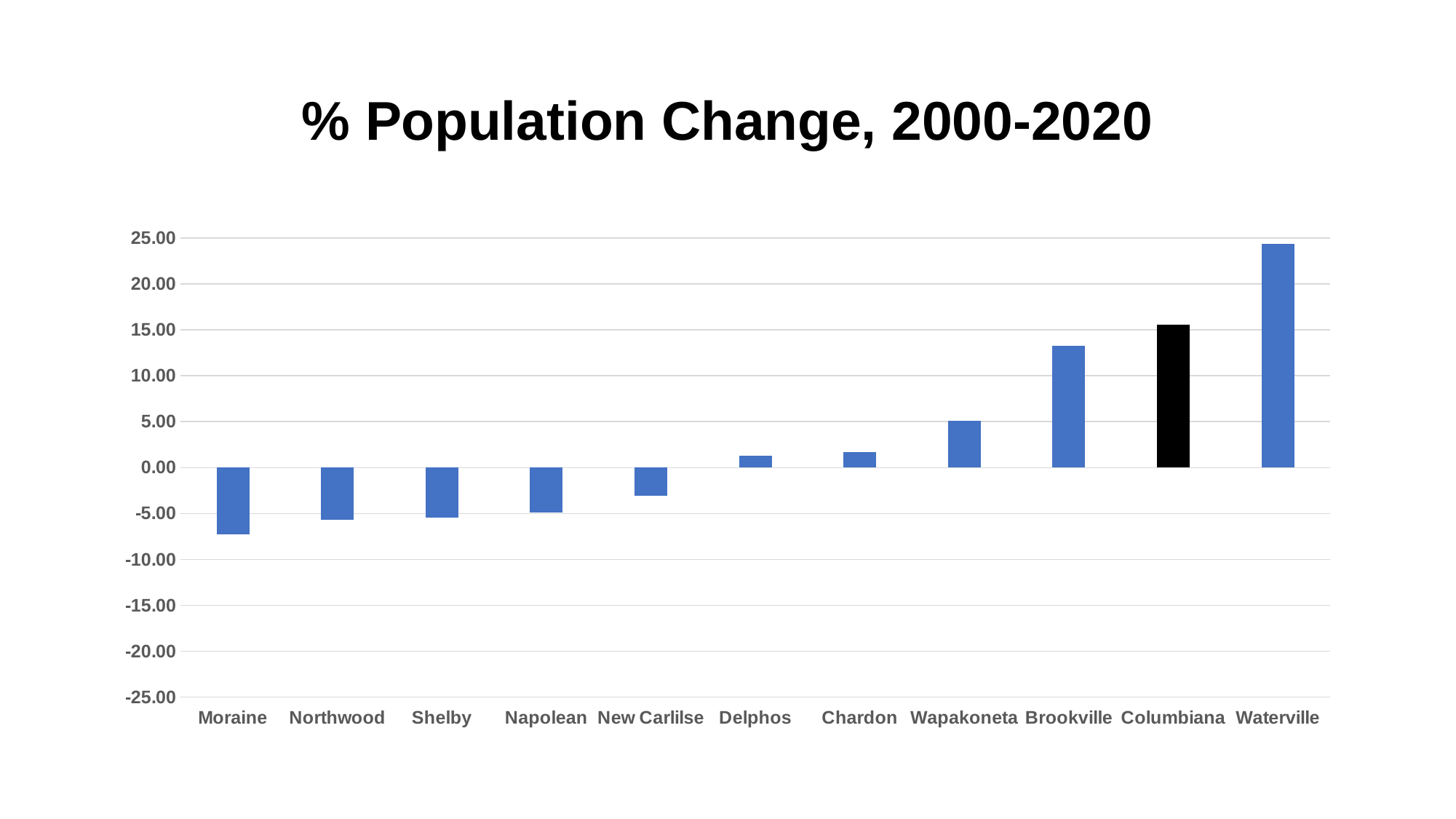
Which city's bar is coloured black rather than blue? Columbiana Is the value for Waterville greater or less than 20.00? greater How many cities are shown on the x axis of the chart? 11 What kind of chart is shown on the slide? bar chart Is the value for New Carlilse greater or less than 0.00? less Is the value for Moraine greater or less than -5.00? less Which has the larger % population change, Waterville or Columbiana? Waterville What is the title of the chart? % Population Change, 2000-2020 Do the values generally rise or fall moving from left to right along the x axis? rise Which city has the highest % population change? Waterville Which city has the lowest % population change? Moraine